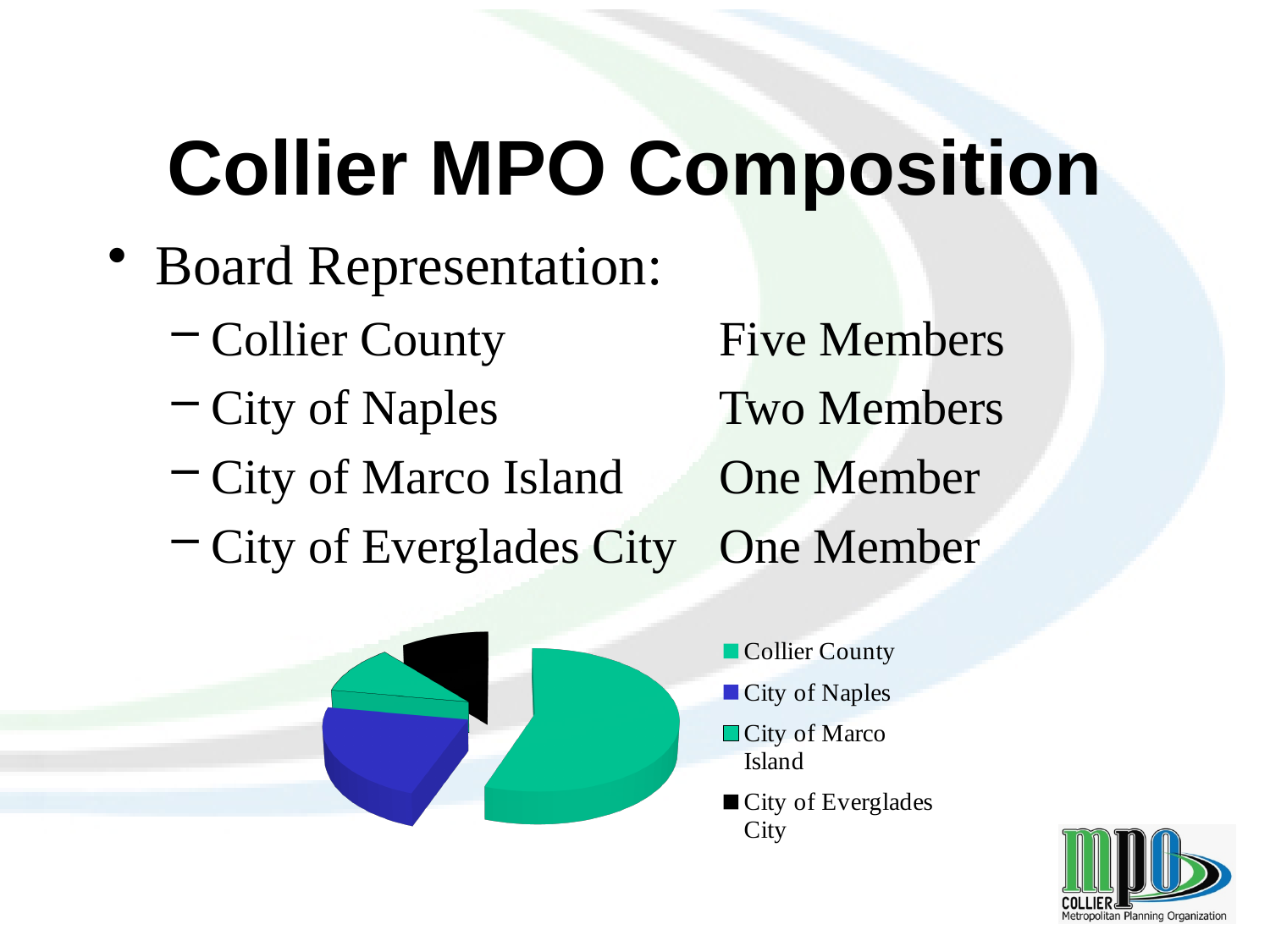
According to the slide, how many members does the City of Marco Island have on the board? One Member Which category has the largest slice of the pie chart? Collier County How many more board members does Collier County have than the City of Naples? 3 According to the slide, how many members does Collier County have on the board? Five Members According to the slide, how many members does the City of Naples have on the board? Two Members Which slice is larger, City of Naples or City of Marco Island? City of Naples Which slice is larger, Collier County or City of Naples? Collier County What colour is the City of Everglades City slice in the pie chart? Black How many slices does the pie chart have? 4 How many entries does the pie chart's legend list? 4 What is the title of the slide containing the pie chart? Collier MPO Composition What kind of chart is shown on the slide? Pie chart